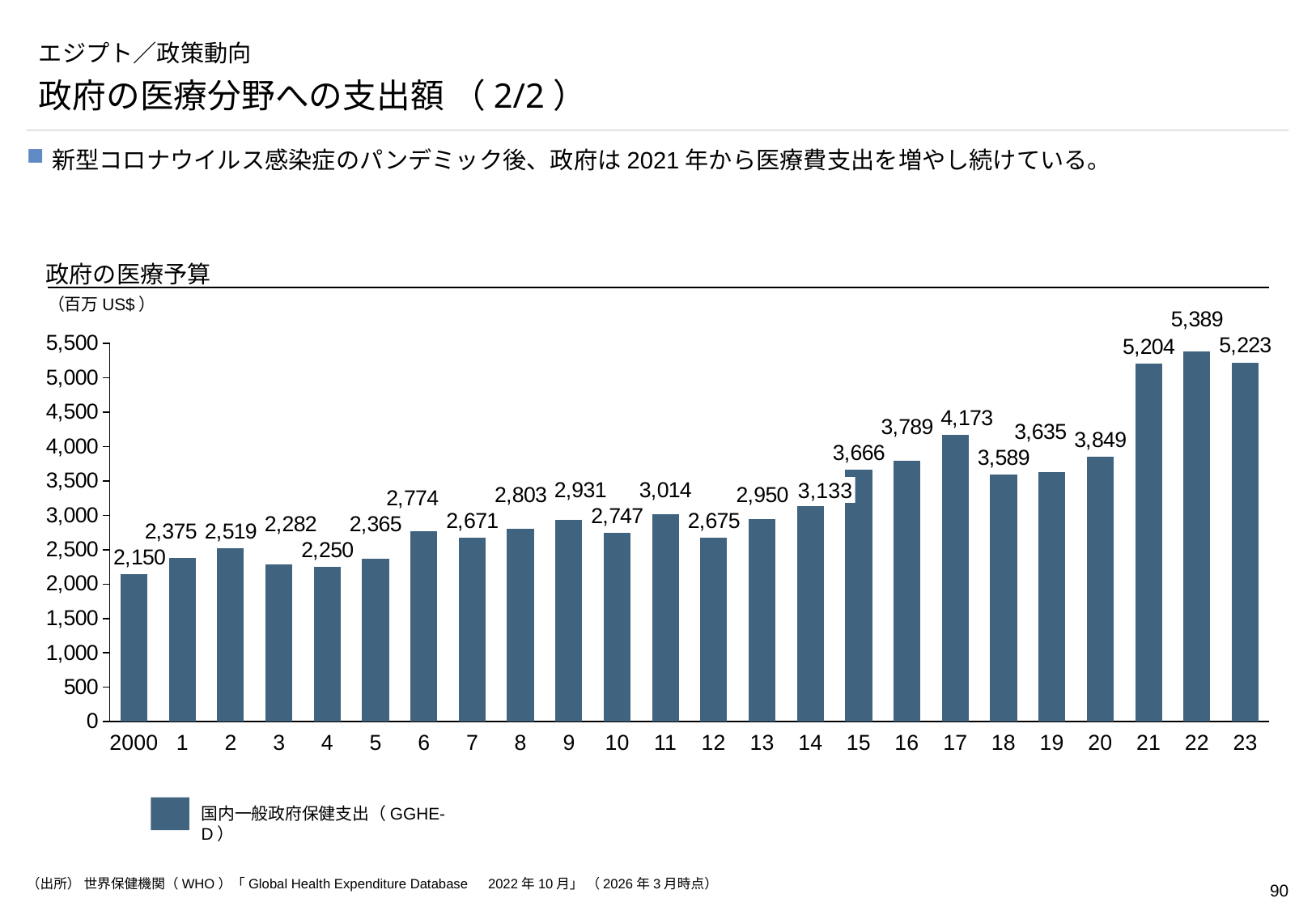
Which year has the lowest value in the 政府の医療予算 chart? 2000 What is the difference between the values for 17 and 16 in the 政府の医療予算 chart? 384 What is the value for 22 in the 政府の医療予算 chart? 5,389 What kind of chart is the 政府の医療予算 chart? bar chart Which is larger in the 政府の医療予算 chart, the value for 18 or the value for 20? 20 Is the value for 14 greater or less than 3,000 in the 政府の医療予算 chart? greater How many bars are plotted in the 政府の医療予算 chart? 24 What is the difference between the values for 22 and 21 in the 政府の医療予算 chart? 185 What is the value for 17 in the 政府の医療予算 chart? 4,173 How many series does the legend of the 政府の医療予算 chart list? 1 What is the value for 2000 in the 政府の医療予算 chart? 2,150 Which year has the highest value in the 政府の医療予算 chart? 22